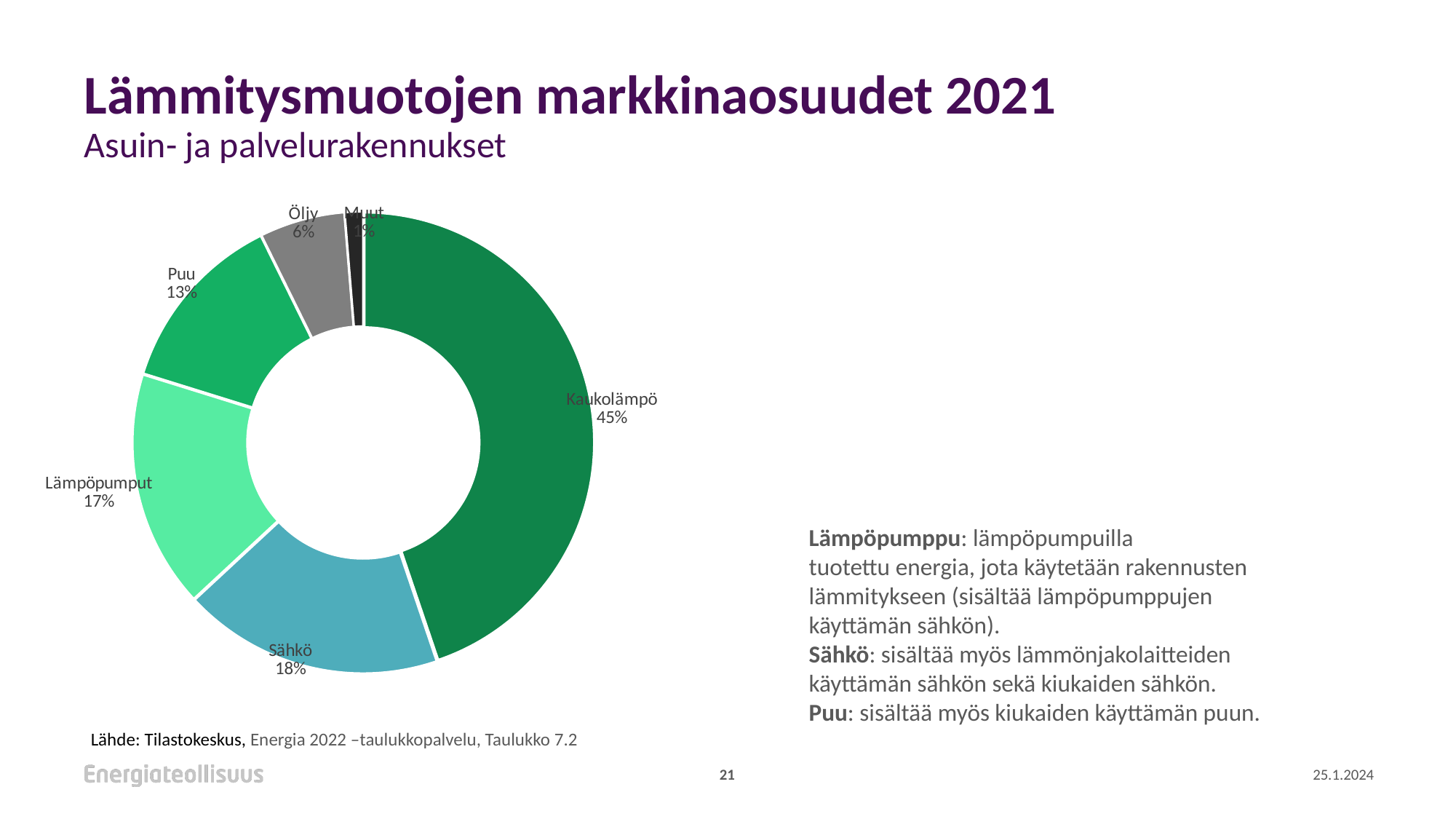
What type of chart is shown on the slide? Donut (pie) chart What percentage is shown for Lämpöpumput? 17% What is the value shown for Puu? 13% What share of the donut chart does Kaukolämpö have? 45% Which has a larger share, Öljy or Sähkö? Sähkö What is the difference in percentage points between Puu and Öljy? 7 How many categories are shown in the donut chart? 6 What percentage is shown for Öljy? 6% Which heating form has the largest share in the chart? Kaukolämpö What is the difference in percentage points between Kaukolämpö and Sähkö? 27 What is the value shown for Sähkö? 18% Which has a larger share, Lämpöpumput or Puu? Lämpöpumput